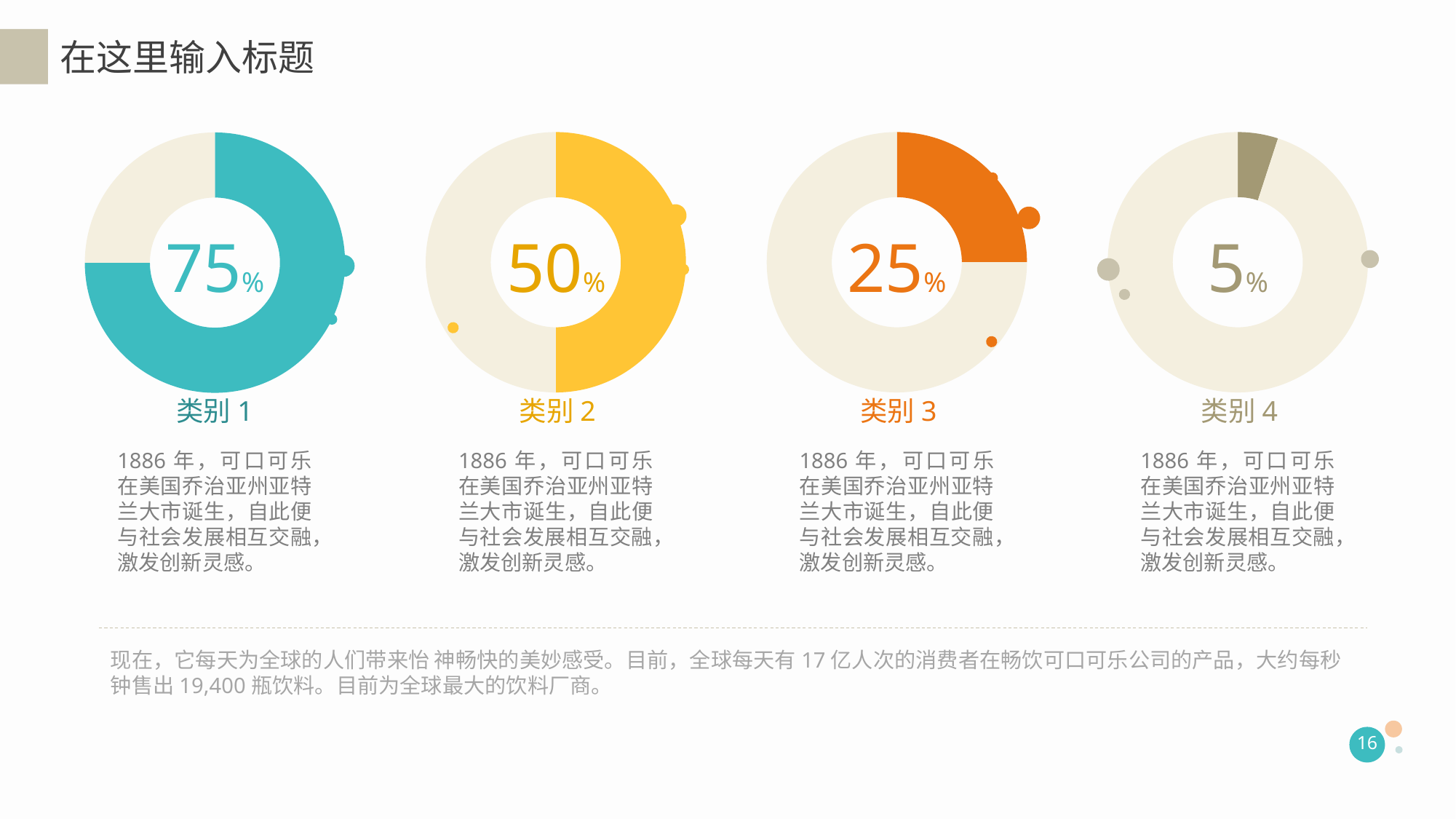
What percentage is shown in the donut chart for 类别 3? 25% How many donut charts are shown on the slide? 4 What kind of chart is used to display each category's percentage? Donut chart What is the difference between the percentages shown for 类别 2 and 类别 4? 45% What colour is the filled portion of the donut chart for 类别 3? Orange What is the difference between the percentages shown for 类别 1 and 类别 3? 50% What percentage is shown in the donut chart for 类别 2? 50% Which is larger, the percentage for 类别 2 or the percentage for 类别 3? 类别 2 What percentage is shown in the donut chart for 类别 4? 5% Which category has the highest percentage among the four donut charts? 类别 1 What percentage is shown in the donut chart for 类别 1? 75% Which category has the lowest percentage among the four donut charts? 类别 4